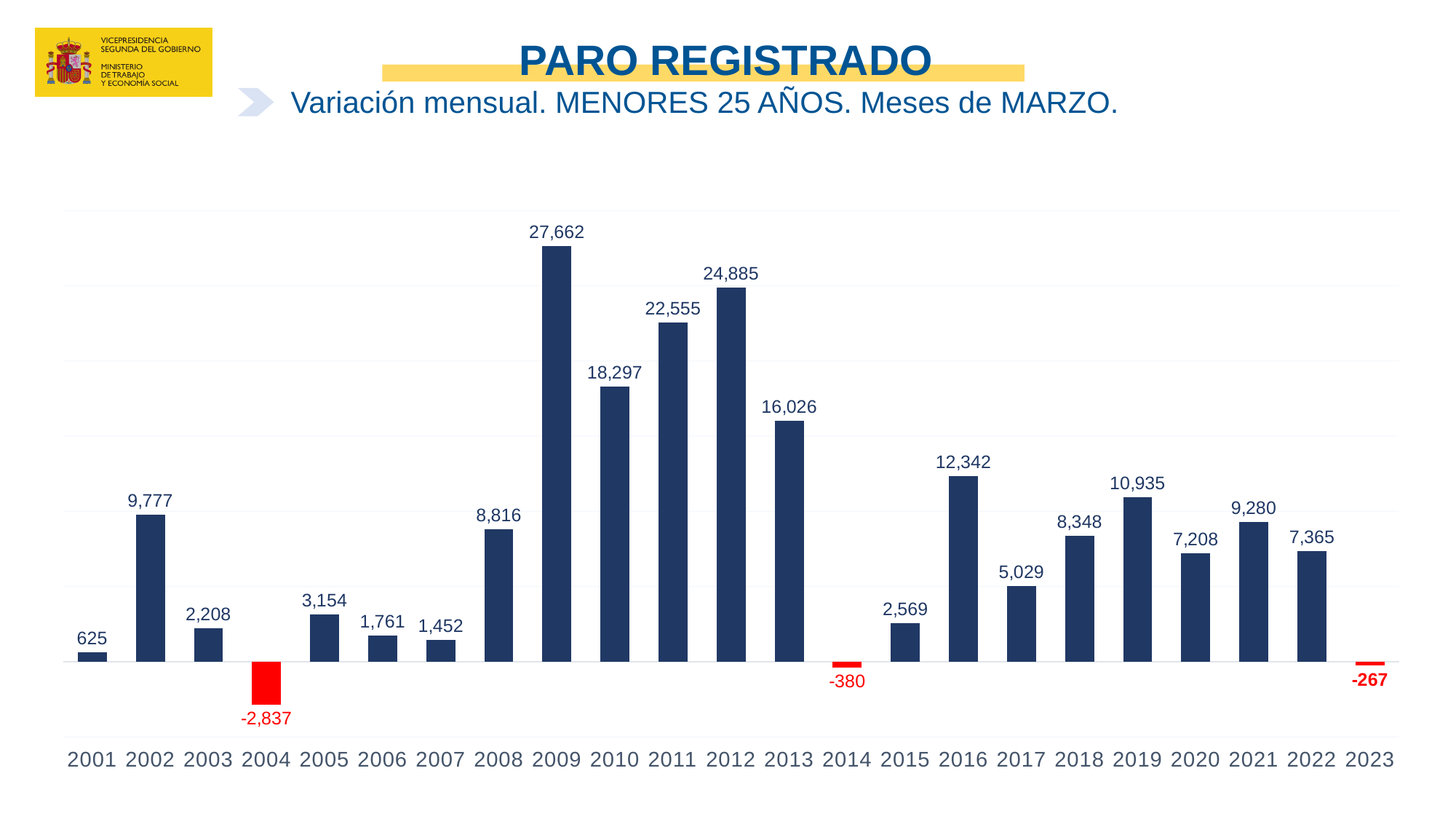
Which year has the lowest value? 2004 Do the values rise or fall from 2009 to 2010? fall What colour are the bars with negative values? red What kind of chart is this? bar chart What is the difference between the values for 2012 and 2011? 2,330 How many years have negative values? 3 What is the value for 2009? 27,662 How many years are shown on the x axis? 23 What is the value for 2023? -267 Which is larger, the value for 2016 or the value for 2019? 2016 What is the value for 2004? -2,837 Which year has the highest value? 2009